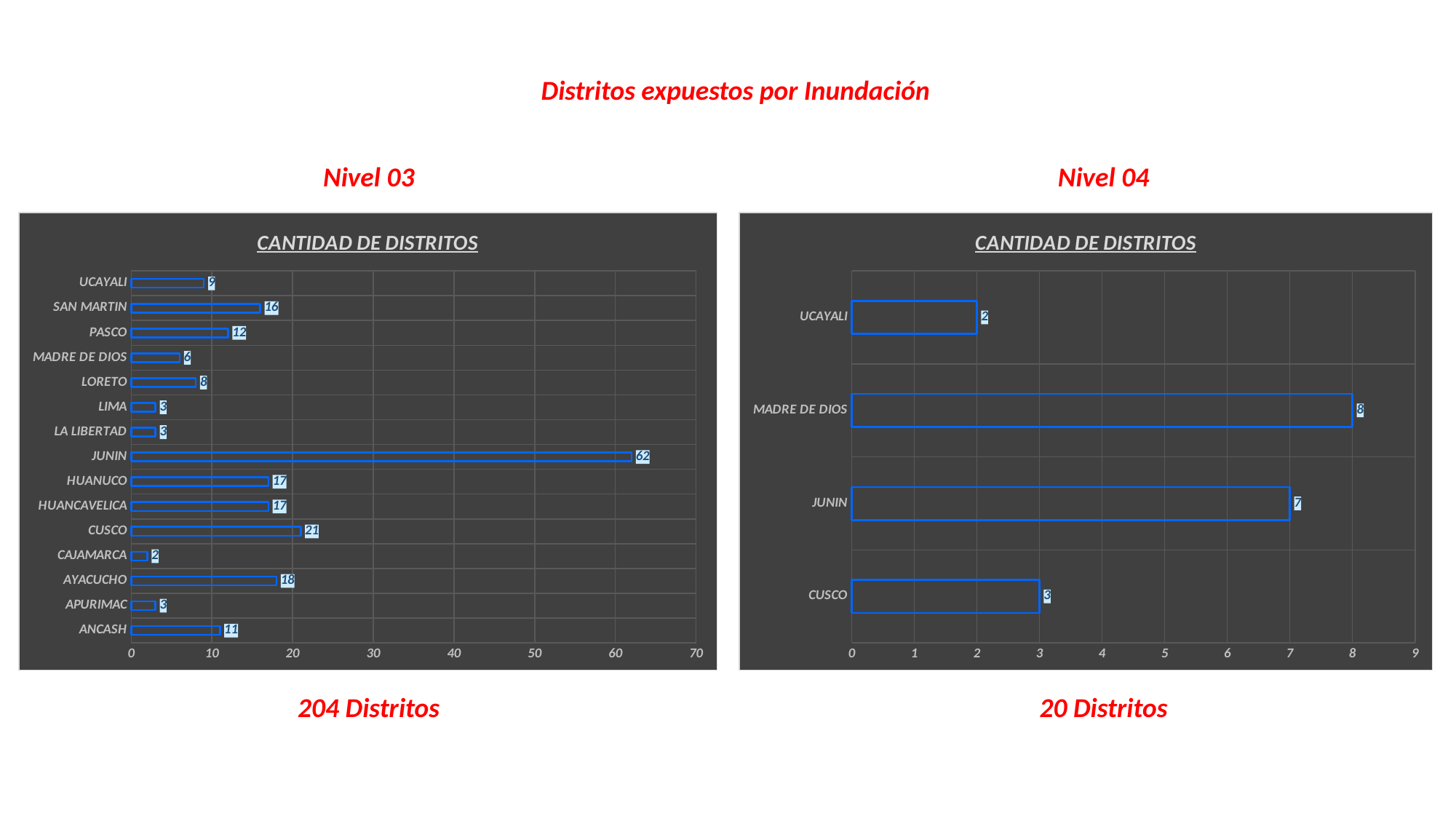
In the Nivel 04 chart, how many regions are listed? 4 In the Nivel 04 chart, what is the value for MADRE DE DIOS? 8 In the Nivel 03 chart, what is the value for CUSCO? 21 In the Nivel 03 chart, which region has the highest value? JUNIN What is the title shown inside the Nivel 03 chart? CANTIDAD DE DISTRITOS In the Nivel 03 chart, which region has the lowest value? CAJAMARCA In the Nivel 03 chart, what is the value for JUNIN? 62 In the Nivel 03 chart, how many regions are listed? 15 In the Nivel 03 chart, what is the difference between the values for AYACUCHO and SAN MARTIN? 2 In the Nivel 04 chart, which is larger, the value for JUNIN or the value for CUSCO? JUNIN What kind of chart is the Nivel 04 chart? Bar chart In the Nivel 04 chart, which region has the lowest value? UCAYALI